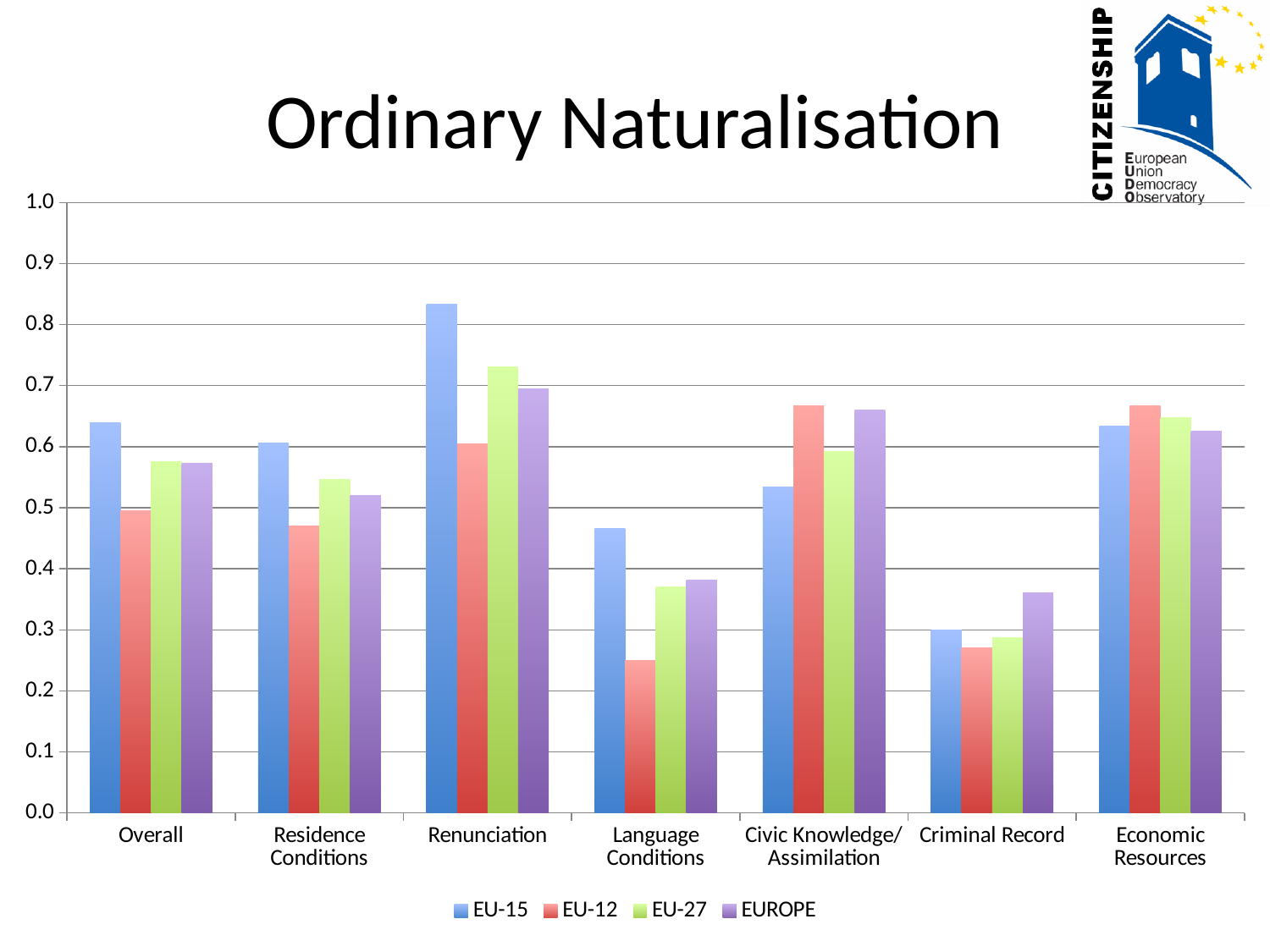
What is the title of the slide's chart? Ordinary Naturalisation For the Overall category, which is larger: EU-15 or EU-12? EU-15 Is the EU-12 value for Language Conditions greater or less than 0.3? less Which category has the highest EU-15 value? Renunciation How many series does the legend list? 4 How many categories are shown along the x axis? 7 For Civic Knowledge/Assimilation, which is larger: EU-12 or EU-15? EU-12 What kind of chart is shown on the slide? bar chart Which category has the lowest EU-12 value? Language Conditions Is the EUROPE value for Criminal Record greater or less than 0.4? less Is the EU-15 value for Renunciation greater or less than 0.8? greater What colour represents the EU-27 series in the legend? green